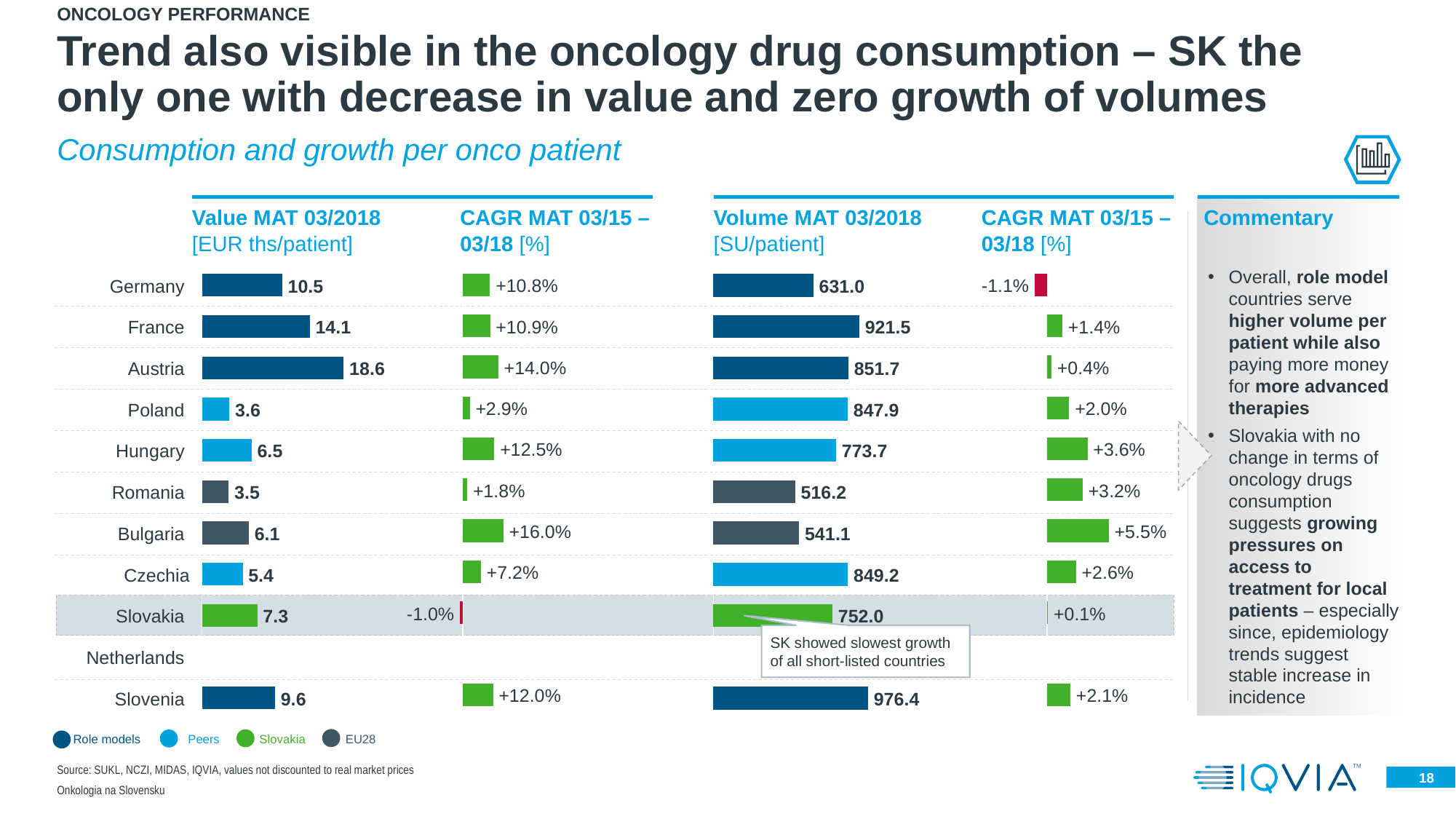
In the Value MAT 03/2018 chart, what is the difference between Austria and France? 4.5 In the CAGR MAT 03/15 – 03/18 chart for volume, what is the growth rate for Germany? -1.1% How many groups does the legend at the bottom of the slide list? 4 In the Volume MAT 03/2018 chart, what is the value for Slovakia? 752.0 In the Volume MAT 03/2018 chart, what is the difference between Slovenia and Germany? 345.4 In the Value MAT 03/2018 chart, what is the value for Austria? 18.6 In the Volume MAT 03/2018 chart, which is larger, France or Austria? France What kind of chart is used to show Value MAT 03/2018? Bar chart In the CAGR MAT 03/15 – 03/18 chart for value, what is the growth rate for Bulgaria? +16.0% In the Value MAT 03/2018 chart, which country has the highest value? Austria In the CAGR MAT 03/15 – 03/18 chart for value, which country has the lowest growth rate? Slovakia In the Volume MAT 03/2018 chart, which country has the lowest volume? Romania